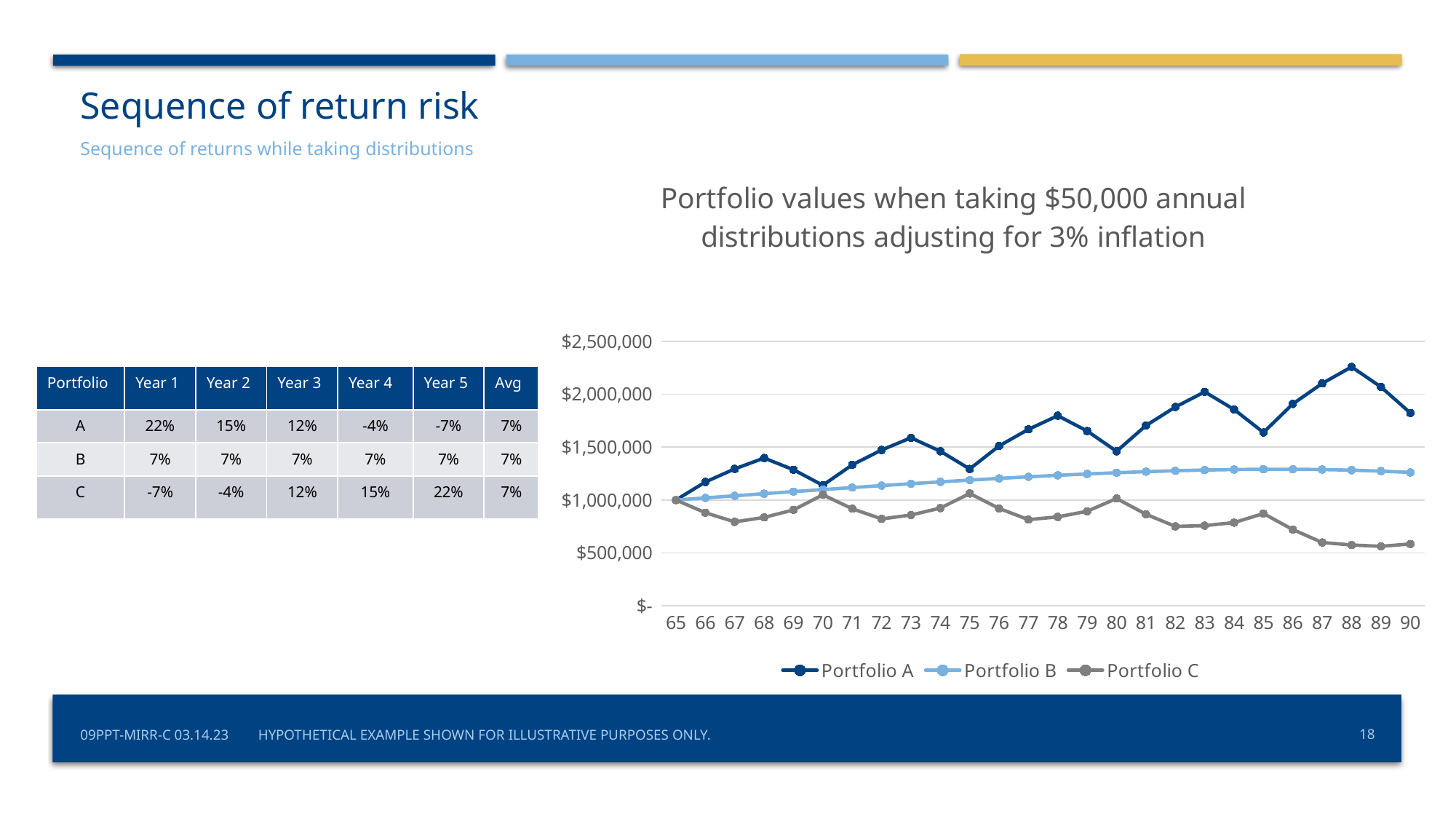
Which series has the lowest value at age 90? Portfolio C What kind of chart is shown on the slide? line chart Is the value for Portfolio B at age 90 greater or less than $1,000,000? greater Is the value for Portfolio C at age 67 greater or less than $1,000,000? less How many series does the chart's legend list? 3 Is the value for Portfolio A at age 88 greater or less than $2,000,000? greater How many ages are plotted along the x axis of the chart? 26 Does the value for Portfolio C overall rise or fall from age 65 to age 90? fall At age 90, which is larger: the value for Portfolio A or the value for Portfolio C? Portfolio A Which series has the highest value at age 88? Portfolio A What is the title of the chart? Portfolio values when taking $50,000 annual distributions adjusting for 3% inflation